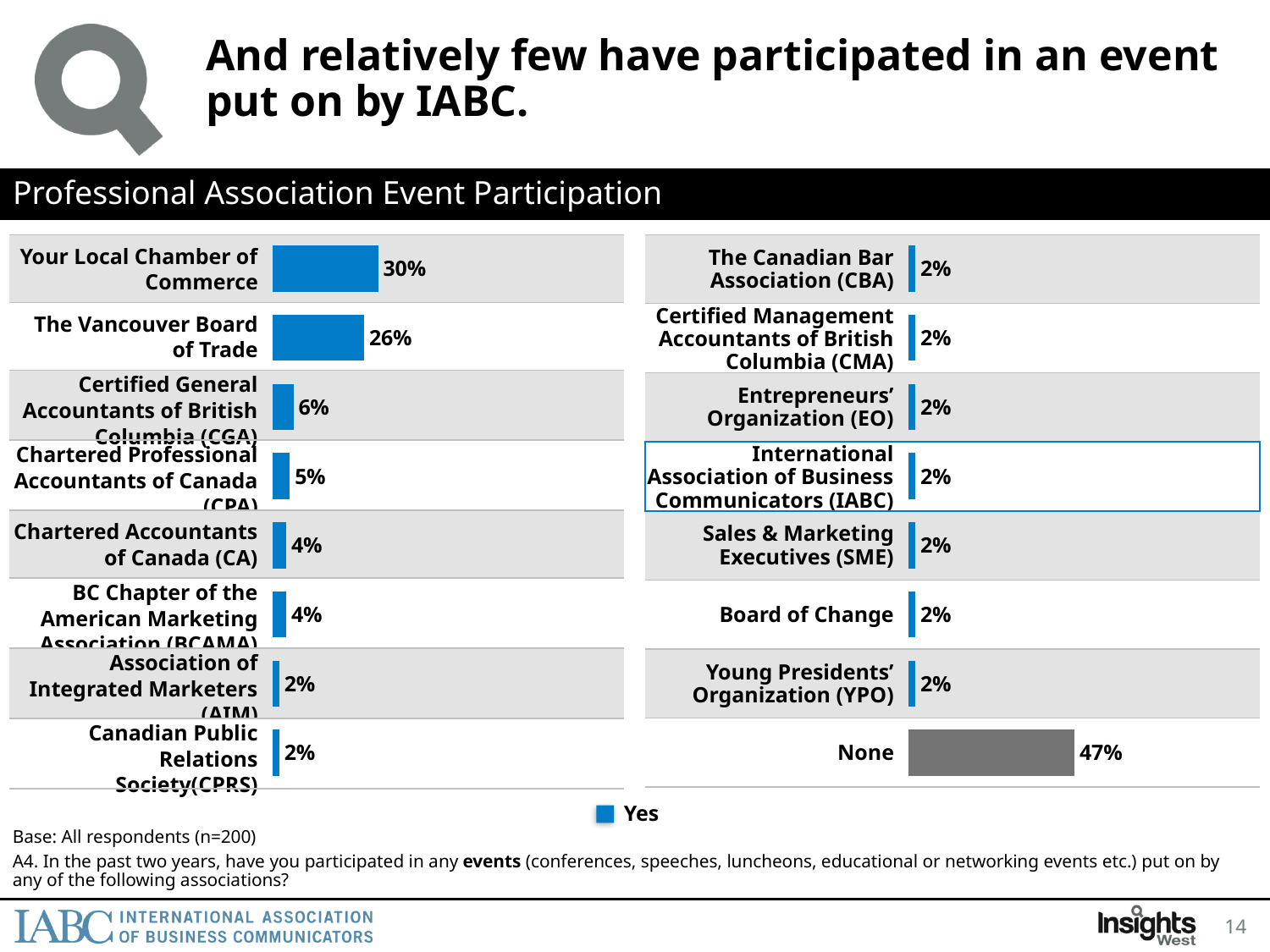
How many categories are shown on the right chart? 8 How many series does the legend list? 1 On the right chart, what is the value for None? 47% On the left chart, what percentage of respondents participated in an event put on by Your Local Chamber of Commerce? 30% On the right chart, which category has the highest value? None On the left chart, which association has the highest participation value? Your Local Chamber of Commerce On the left chart, which is larger: Certified General Accountants of British Columbia (CGA) or Chartered Professional Accountants of Canada (CPA)? Certified General Accountants of British Columbia (CGA) What type of chart is used on this slide? Bar chart On the left chart, what is the difference between Your Local Chamber of Commerce and The Vancouver Board of Trade? 4 percentage points On the left chart, what is the value for The Vancouver Board of Trade? 26% On the right chart, what percentage participated in an event put on by the International Association of Business Communicators (IABC)? 2% How many categories are shown on the left chart? 8